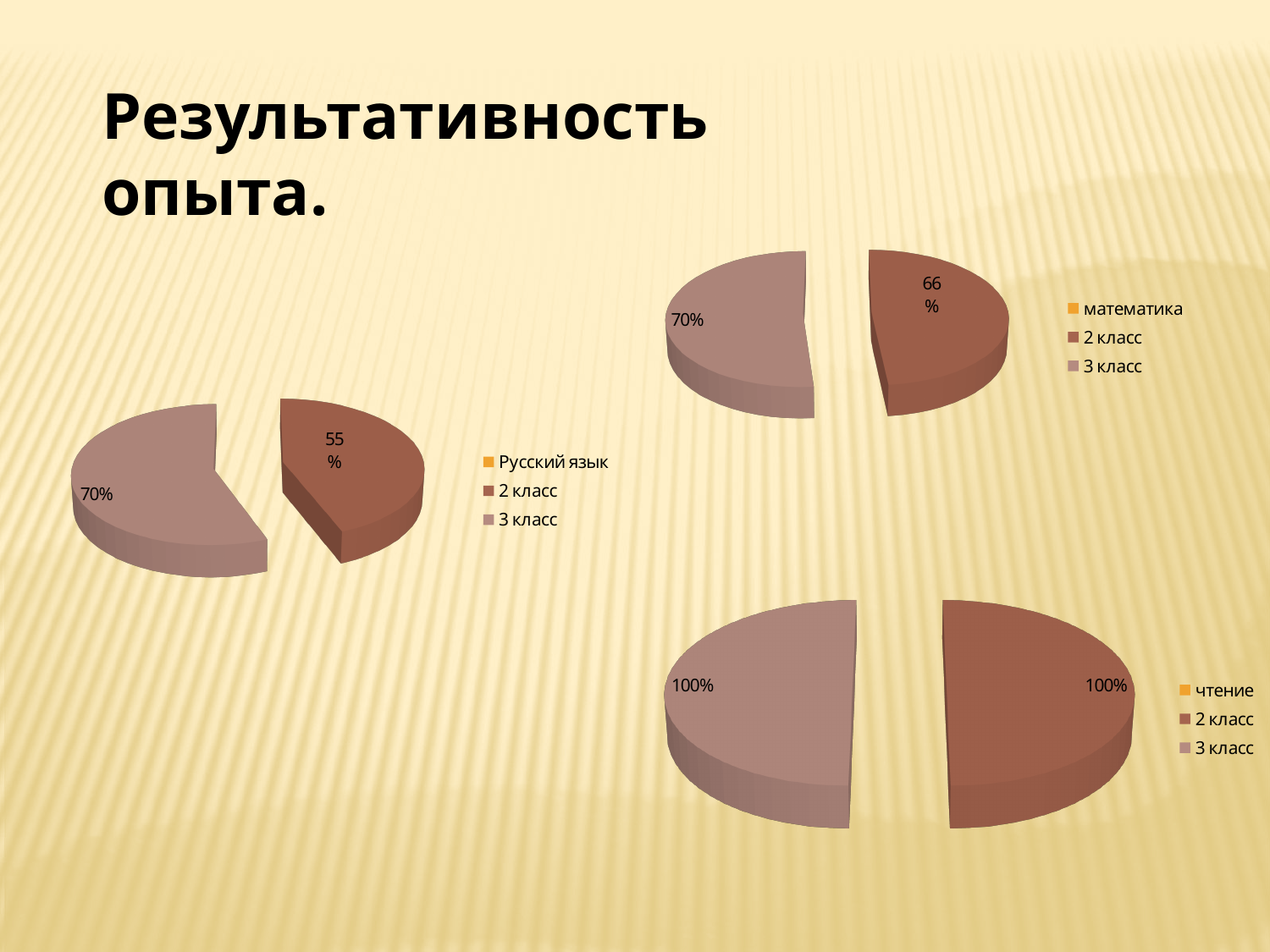
On the left pie chart (Русский язык), which is larger, the value for 2 класс or for 3 класс? 3 класс On the left pie chart (Русский язык), what value is shown for 2 класс? 55% On the left pie chart (Русский язык), what value is shown for 3 класс? 70% What type of chart is the bottom-right chart (чтение)? Pie chart On the bottom-right pie chart (чтение), what value is shown for 2 класс? 100% How many entries does the legend of the top-right chart (математика) list? 3 How many pie charts are shown on the slide? 3 On the top-right pie chart (математика), what value is shown for 3 класс? 70% On the bottom-right pie chart (чтение), how many slices are labelled? 2 On the left pie chart (Русский язык), what is the difference between the values for 3 класс and 2 класс? 15% On the top-right pie chart (математика), what value is shown for 2 класс? 66% On the top-right pie chart (математика), what is the difference between the values for 3 класс and 2 класс? 4%